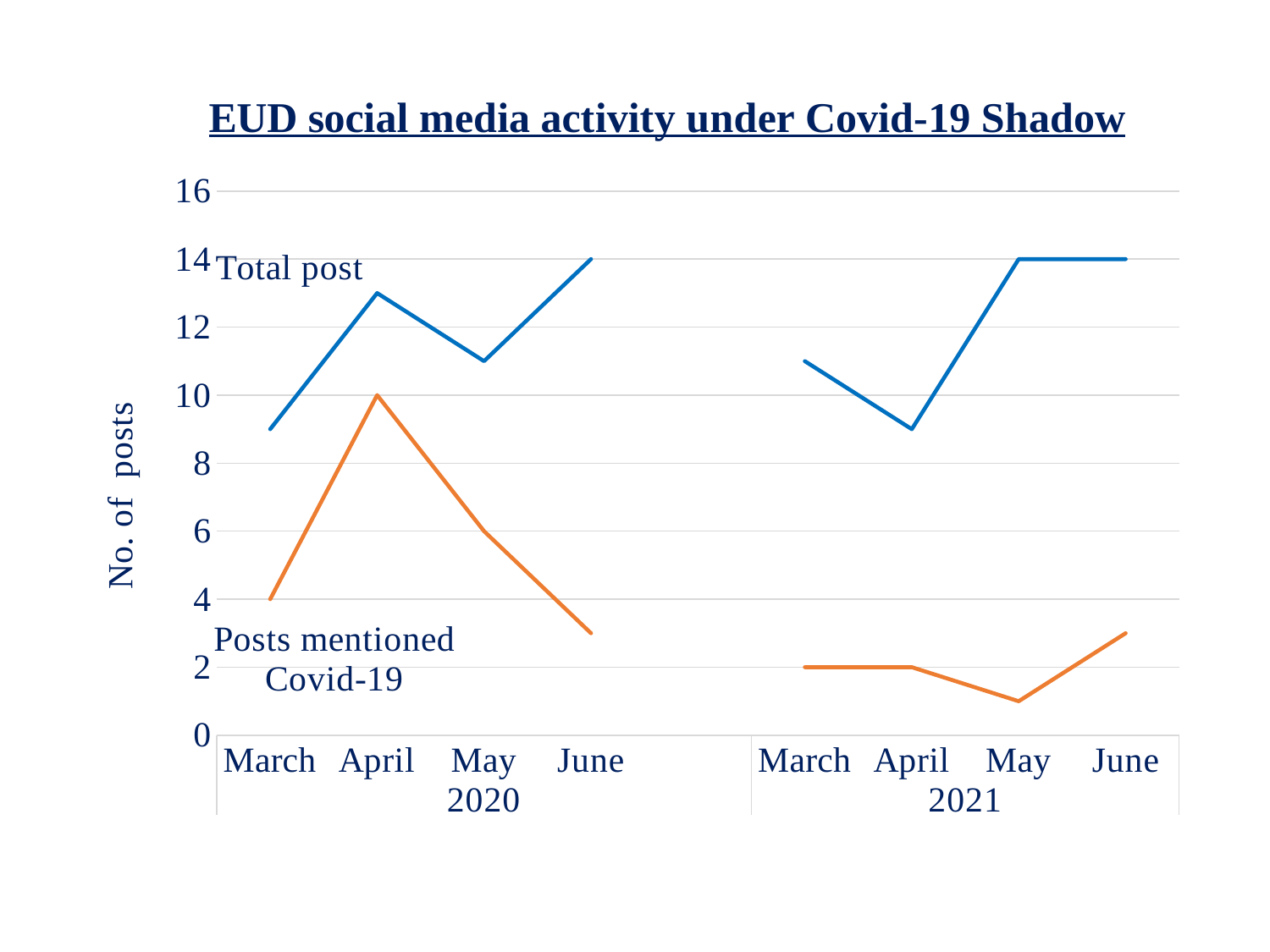
In which month is Posts mentioned Covid-19 lowest? May 2021 How many months (data points) are shown along the x axis? 8 What is the difference between Posts mentioned Covid-19 in April 2020 and March 2020? 6 What is the value of Posts mentioned Covid-19 for April 2020? 10 What is the value of Posts mentioned Covid-19 for March 2020? 4 What is the value of Total post for June 2020? 14 Which is larger for Total post: April 2020 or May 2020? April 2020 In which month is Posts mentioned Covid-19 highest? April 2020 Is the value of Total post for March 2020 greater or less than 8? greater What is the value of Posts mentioned Covid-19 for March 2021? 2 What kind of chart is shown on the slide? line chart How many series are plotted on the chart? 2